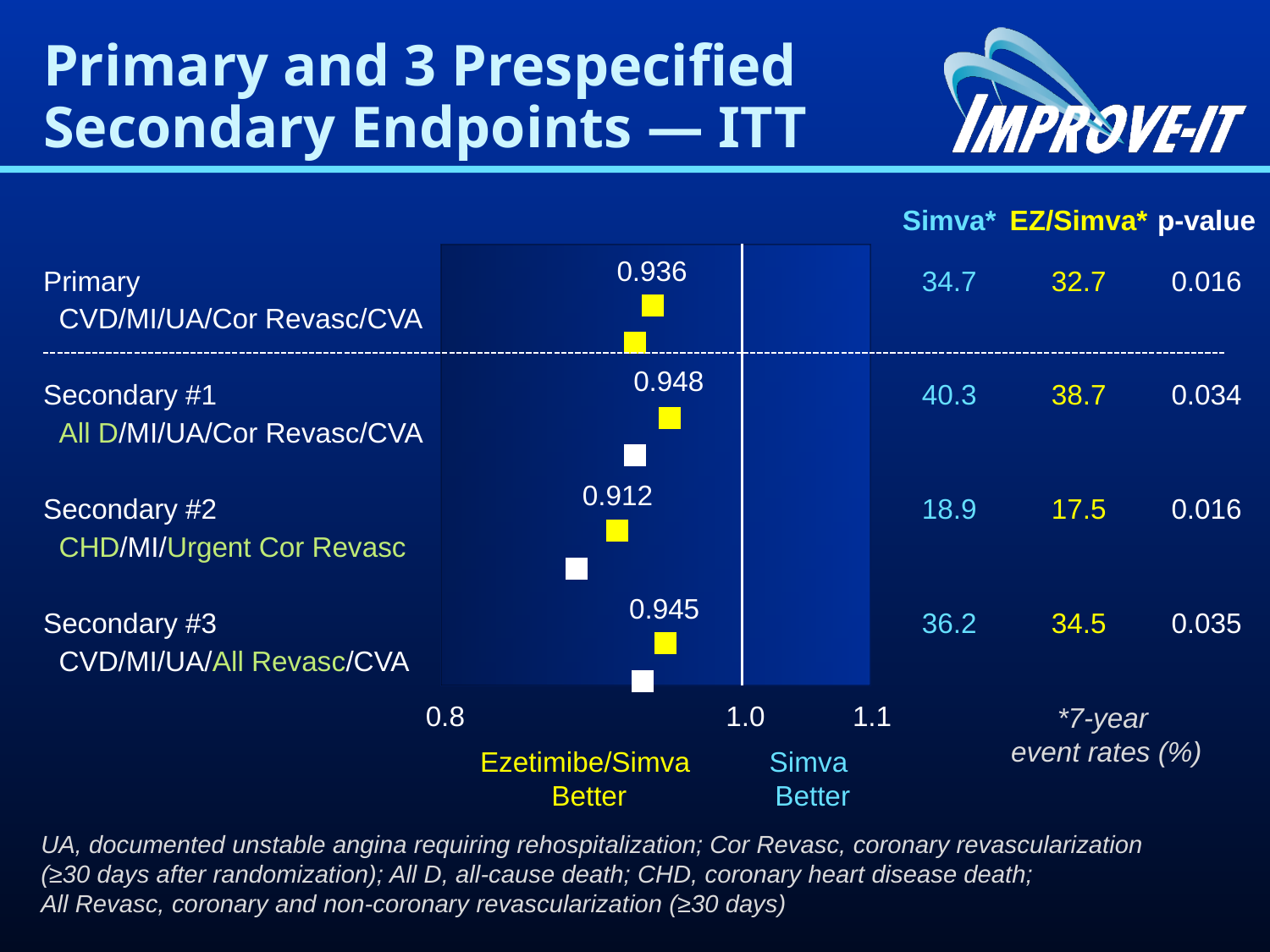
What is the 7-year event rate for EZ/Simva on the Primary endpoint? 32.7 What is the hazard ratio plotted for Secondary #3 (CVD/MI/UA/All Revasc/CVA)? 0.945 Which endpoint has the highest plotted hazard ratio? Secondary #1 Is the hazard ratio for the Primary endpoint greater or less than 1.0? less What is the p-value for Secondary #3? 0.035 What is the hazard ratio plotted for Secondary #2 (CHD/MI/Urgent Cor Revasc)? 0.912 Which side of the 1.0 reference line is labelled 'Ezetimibe/Simva Better'? The left side How many endpoints are plotted on the chart? 4 What is the difference between the Simva and EZ/Simva 7-year event rates for Secondary #1? 1.6 What is the hazard ratio plotted for the Primary endpoint (CVD/MI/UA/Cor Revasc/CVA)? 0.936 Which endpoint has the lowest plotted hazard ratio? Secondary #2 What is the difference between the hazard ratios for Secondary #1 and Secondary #2? 0.036